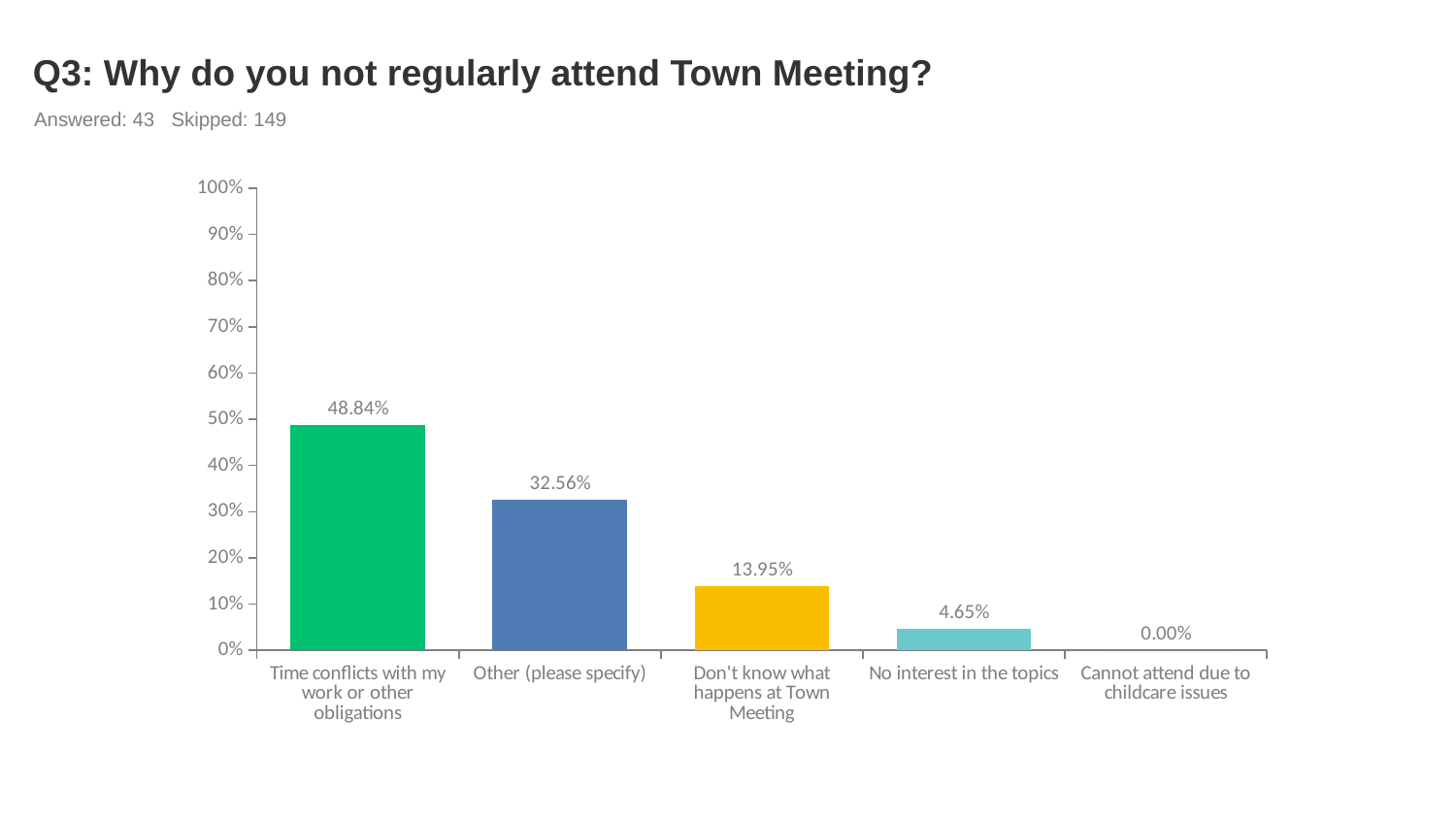
What is the difference between the percentages for "Time conflicts with my work or other obligations" and "Other (please specify)"? 16.28% How many reason categories are shown on the chart? 5 How many respondents answered this question according to the slide? 43 Which is larger: the value for "Don't know what happens at Town Meeting" or the value for "No interest in the topics"? Don't know what happens at Town Meeting What is the value for "No interest in the topics"? 4.65% Which reason has the highest percentage? Time conflicts with my work or other obligations Is the value for "Time conflicts with my work or other obligations" greater or less than 40%? greater What kind of chart is shown on the slide? Bar chart What is the value shown for "Other (please specify)"? 32.56% What percentage is shown for "Don't know what happens at Town Meeting"? 13.95% What percentage of respondents cited "Time conflicts with my work or other obligations" as the reason they do not regularly attend Town Meeting? 48.84% Which reason has the lowest percentage? Cannot attend due to childcare issues